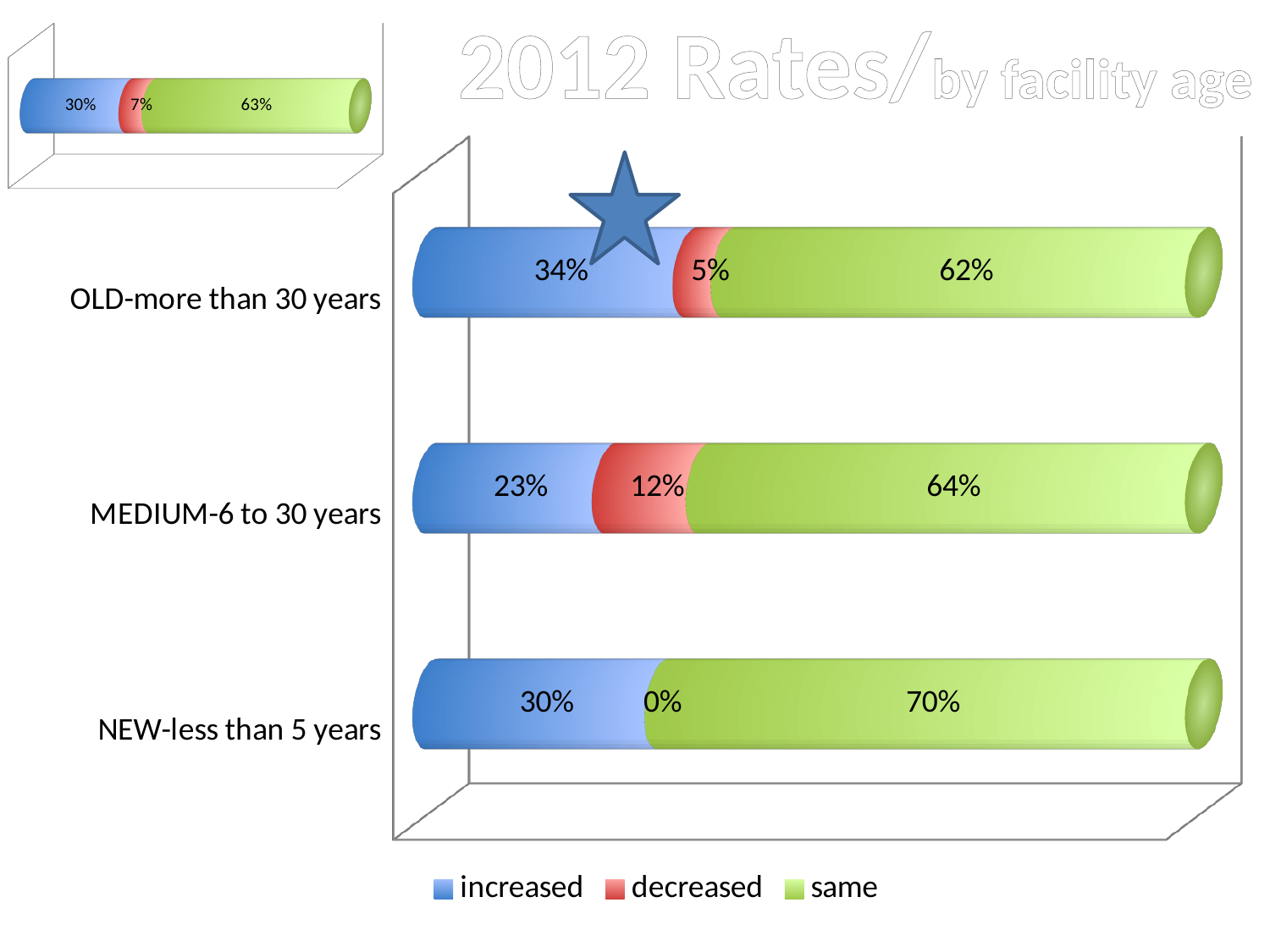
In the 2012 Rates by facility age chart, what is the difference between the 'same' percentages for MEDIUM-6 to 30 years and OLD-more than 30 years? 2% What kind of chart is the 2012 Rates by facility age chart? Stacked bar chart How many series does the legend of the 2012 Rates by facility age chart list? 3 In the small chart in the top-left corner of the slide, what is the value of the red (decreased) segment? 7% In the 2012 Rates by facility age chart, which is larger: the decreased percentage for OLD-more than 30 years or for MEDIUM-6 to 30 years? MEDIUM-6 to 30 years In the 2012 Rates by facility age chart, what percentage of MEDIUM-6 to 30 years facilities decreased? 12% In the 2012 Rates by facility age chart, which facility age group has the lowest 'increased' percentage? MEDIUM-6 to 30 years In the 2012 Rates by facility age chart, which facility age group has the highest 'same' percentage? NEW-less than 5 years In the 2012 Rates by facility age chart, what percentage of OLD-more than 30 years facilities increased? 34% In the 2012 Rates by facility age chart, what is the decreased value for NEW-less than 5 years? 0% In the 2012 Rates by facility age chart, what percentage of NEW-less than 5 years facilities stayed the same? 70% How many facility age categories are shown in the 2012 Rates by facility age chart? 3